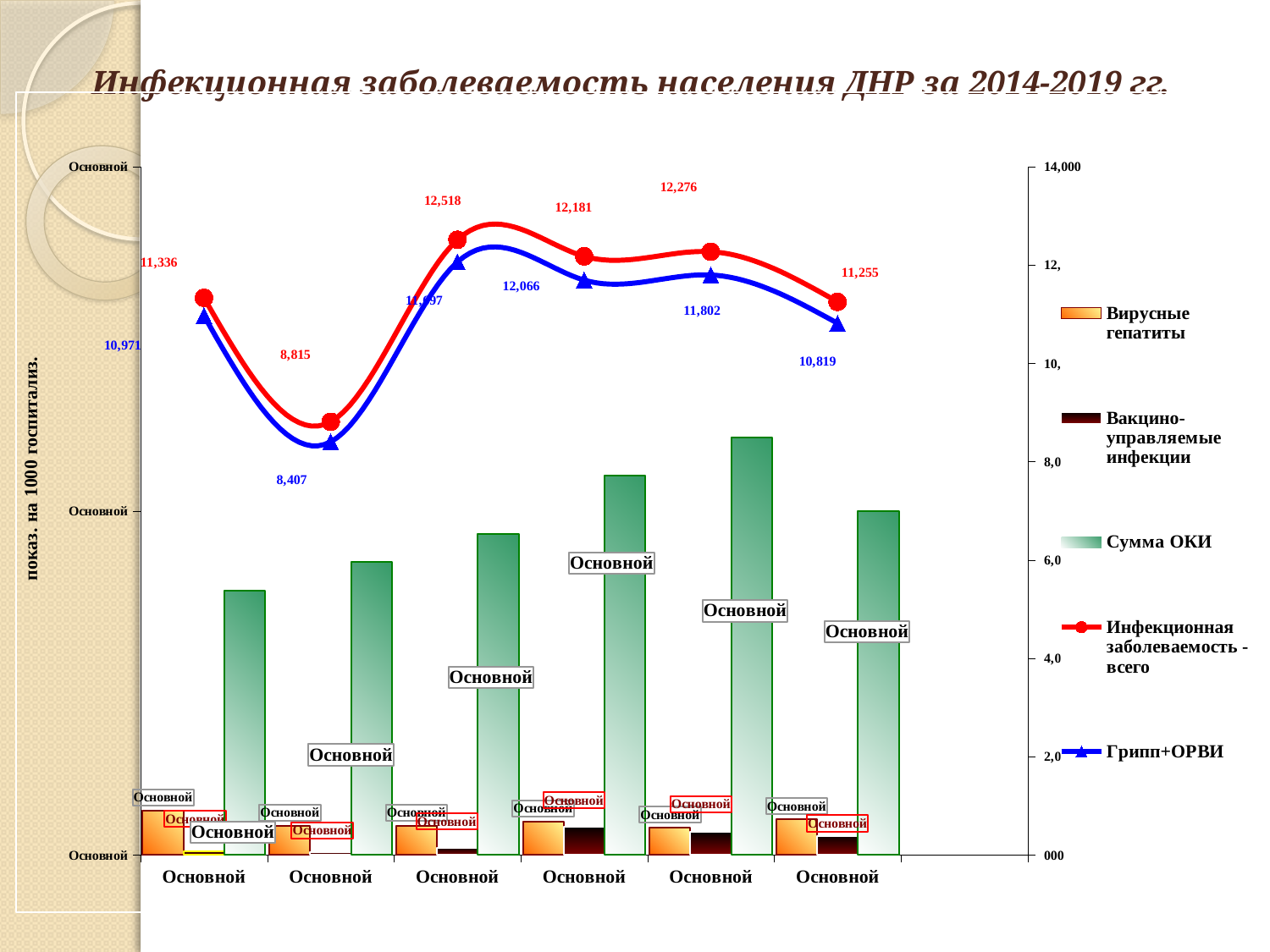
What is the highest value labelled on the red line (Инфекционная заболеваемость - всего)? 12,518 How many points are plotted on each line? 6 At the last point on the right, which is larger: the red line (Инфекционная заболеваемость - всего) or the blue line (Грипп+ОРВИ)? The red line (Инфекционная заболеваемость - всего) What is the highest value labelled on the blue line (Грипп+ОРВИ)? 12,066 What is the lowest value labelled on the red line (Инфекционная заболеваемость - всего)? 8,815 What is the lowest value labelled on the blue line (Грипп+ОРВИ)? 8,407 What is the value of the red line (Инфекционная заболеваемость - всего) at the first point from the left? 11,336 What is the value of the blue line (Грипп+ОРВИ) at the last point on the right? 10,819 What kind of chart is shown on the slide? A combined bar and line chart Which of the green Сумма ОКИ bars is the tallest? The fifth bar from the left At the second point from the left, what is the difference between the red line value (8,815) and the blue line value (8,407)? 408 How many series does the legend list? 5